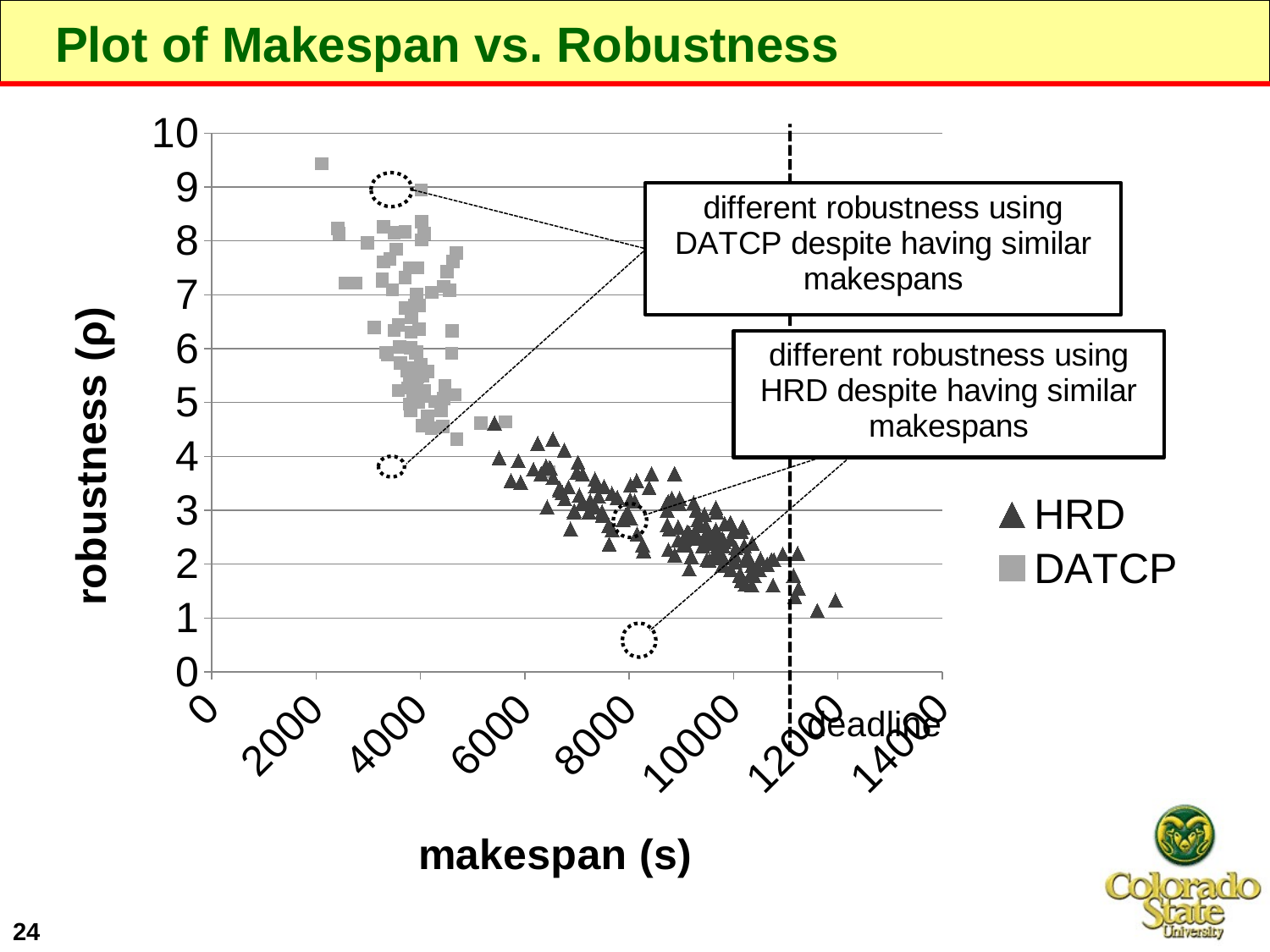
What are the two series named in the legend? HRD and DATCP What kind of chart is shown on the slide? scatter plot How many series does the legend list? 2 Which series has the higher robustness values overall, HRD or DATCP? DATCP As makespan increases along the x axis, does robustness rise or fall? fall Which series has the larger makespan values overall, HRD or DATCP? HRD What is the title of the slide? Plot of Makespan vs. Robustness What is the label of the y axis? robustness (ρ) Are the HRD points mostly at makespans greater or less than 6000? greater Are the DATCP points mostly at makespans greater or less than 6000? less